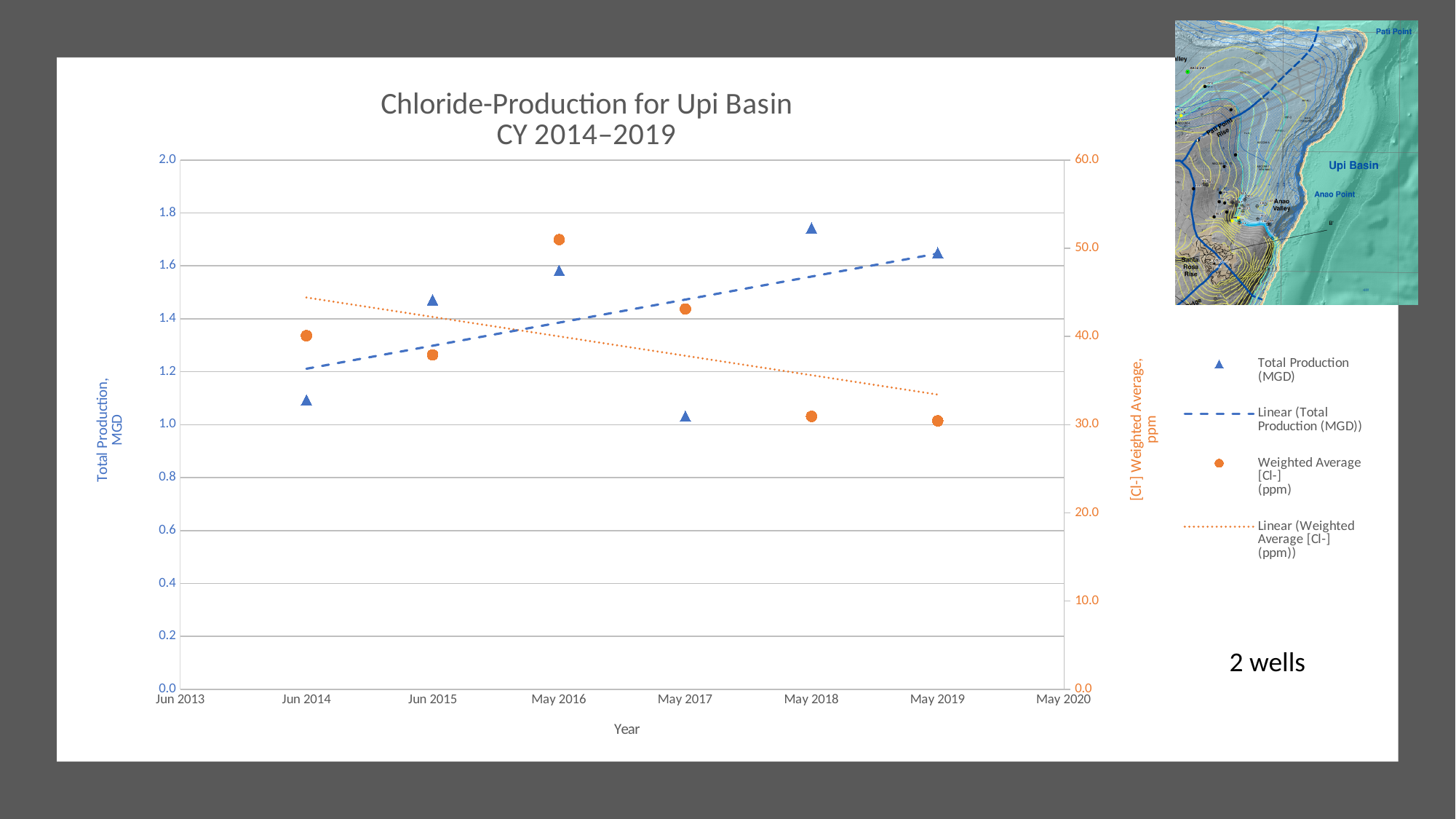
How many data points are plotted for the Total Production (MGD) series? 6 What is the title of the chart? Chloride-Production for Upi Basin CY 2014–2019 Is the Weighted Average [Cl-] (ppm) value for May 2018 greater or less than 40.0? less What kind of chart is shown on the slide? Scatter chart Does the Linear (Weighted Average [Cl-] (ppm)) trendline rise or fall from left to right? Fall In which year is the Weighted Average [Cl-] (ppm) highest? May 2016 Which is larger, the Total Production (MGD) for Jun 2015 or for May 2016? May 2016 In which year is Total Production (MGD) lowest? May 2017 How many entries does the chart legend list? 4 Is the Weighted Average [Cl-] (ppm) value for May 2017 greater or less than 40.0? greater In which year is Total Production (MGD) highest? May 2018 Is the Total Production (MGD) value for Jun 2014 greater or less than 1.2? less